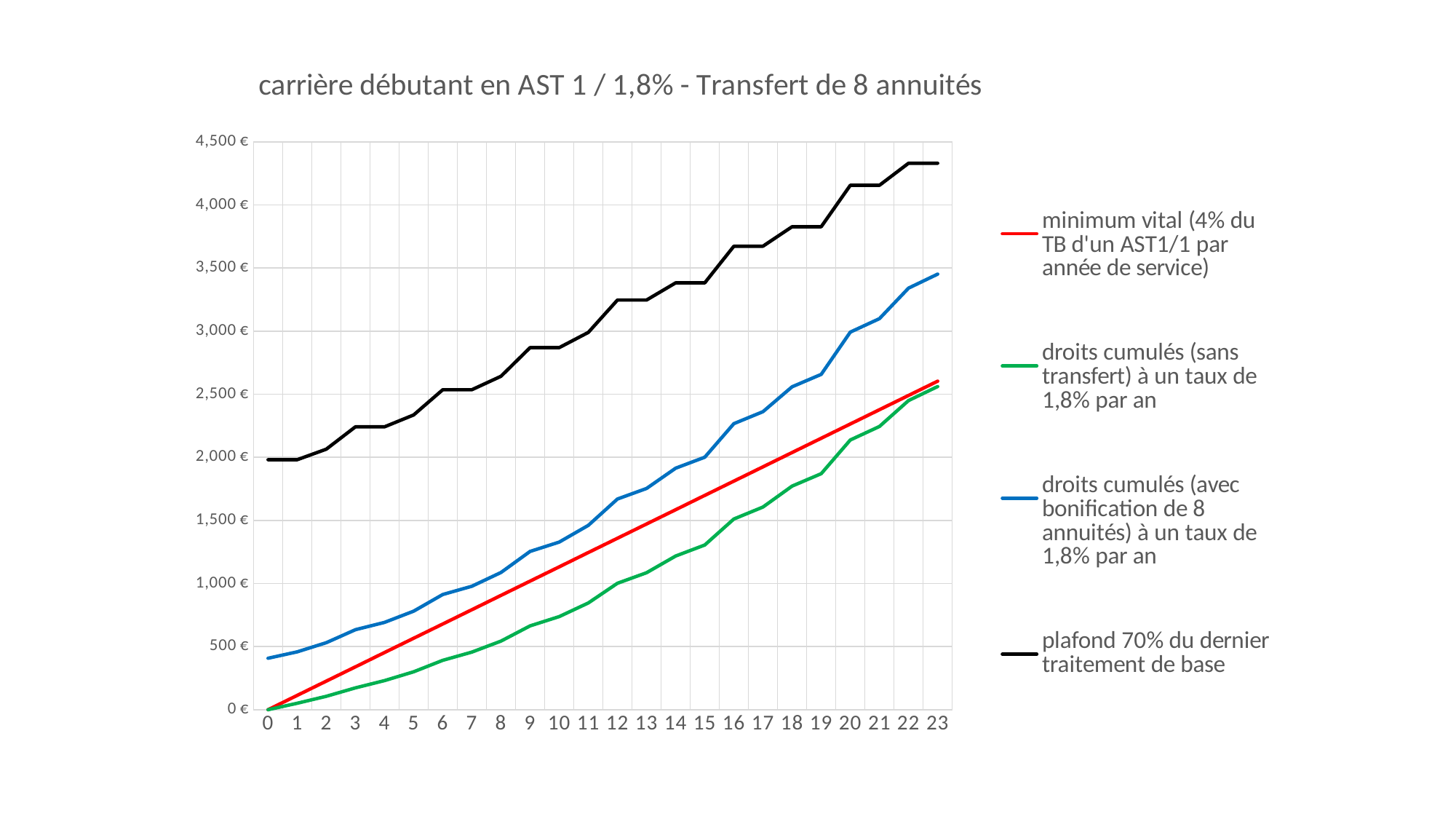
Is the value of 'plafond 70% du dernier traitement de base' at x = 23 greater or less than 4,000 €? greater What kind of chart is shown on the slide? line chart How many points are plotted along the x axis for each series (from 0 to 23)? 24 How many series does the legend list? 4 At x = 23, which is larger: the 'droits cumulés (avec bonification de 8 annuités)' series or the 'droits cumulés (sans transfert)' series? droits cumulés (avec bonification de 8 annuités) What colour is the line for 'plafond 70% du dernier traitement de base'? black Is the value of 'droits cumulés (avec bonification de 8 annuités)' at x = 23 greater or less than 3,500 €? less Is the value of 'plafond 70% du dernier traitement de base' at x = 0 greater or less than 2,500 €? less What is the value of the 'droits cumulés (sans transfert)' series at x = 0? 0 € Do the values of the 'minimum vital' series rise or fall as x increases from 0 to 23? rise Which series has the highest value at x = 23? plafond 70% du dernier traitement de base